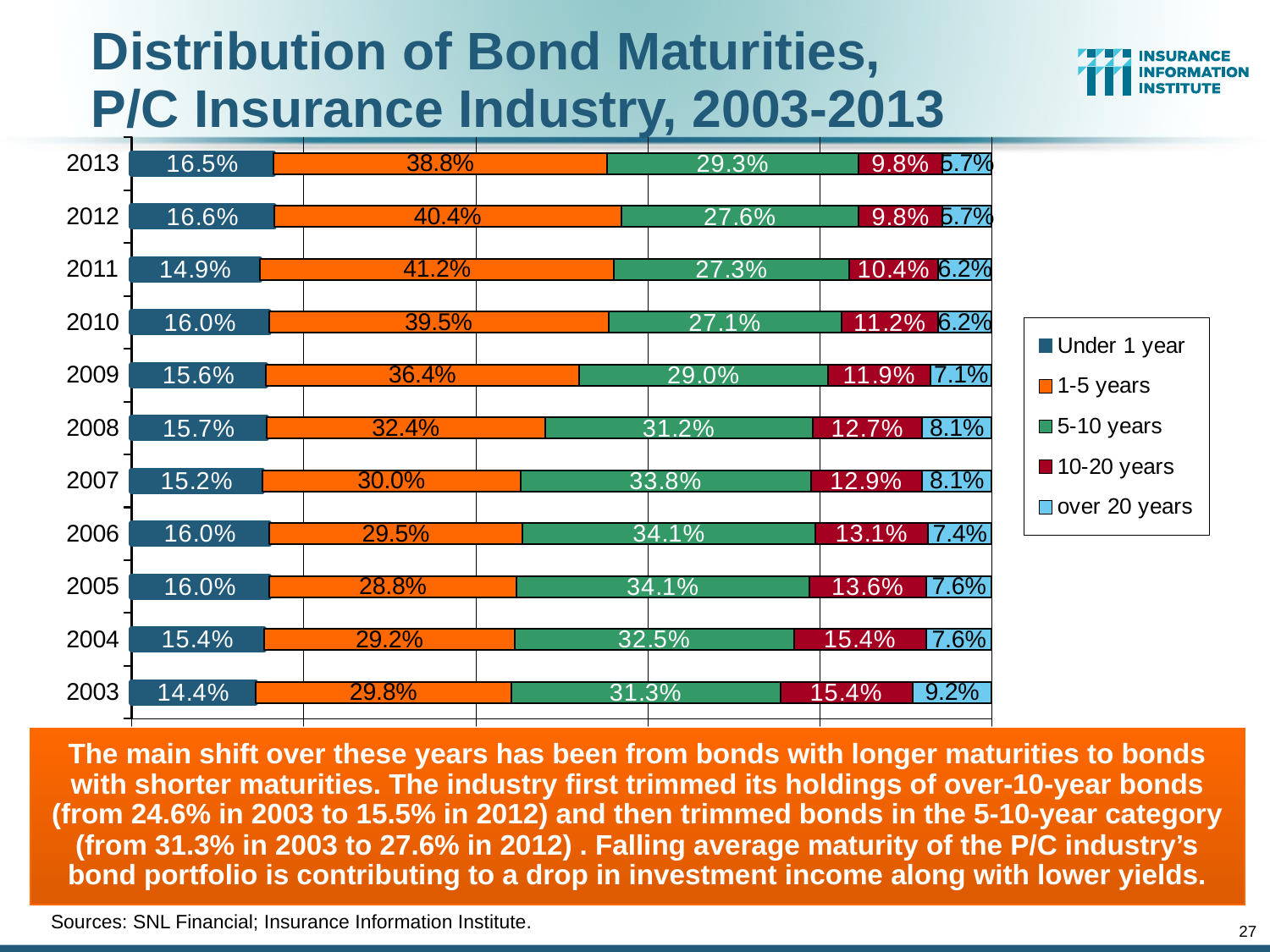
By how many percentage points did the 1-5 years share in 2013 exceed the 1-5 years share in 2003? 9.0 percentage points What percentage of bonds had a 10-20 year maturity in 2008? 12.7% What percentage of bonds had a 1-5 year maturity in 2013? 38.8% What type of chart is shown on the slide? Stacked bar chart In which year was the over 20 years share the highest? 2003 In which year was the Under 1 year share the lowest? 2003 Which was larger in 2007: the 1-5 years share or the 5-10 years share? 5-10 years How many maturity categories does the legend list? 5 What was the share of bonds with over 20 years maturity in 2003? 9.2% Did the over 20 years share rise or fall from 2003 to 2013? Fall In which year was the 1-5 years share the highest? 2011 How many years are shown on the chart? 11